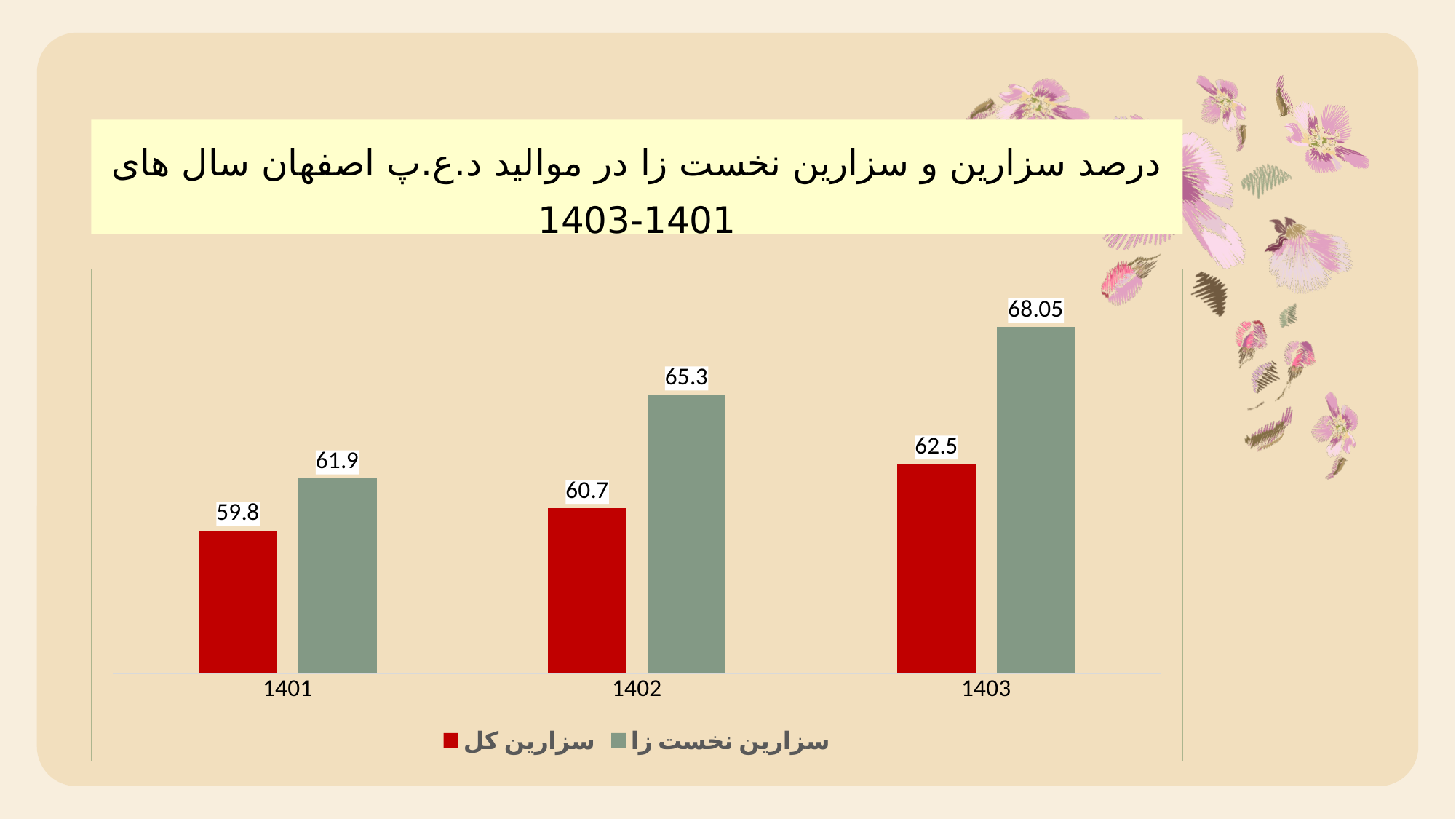
In which year is سزارین کل lowest? 1401 What is the value of سزارین کل for 1403? 62.5 Do the values of سزارین کل rise or fall from 1401 to 1403? Rise What is the difference between سزارین نخست زا and سزارین کل in 1402? 4.6 What is the value of سزارین نخست زا for 1402? 65.3 What is the value of سزارین نخست زا (grey-green bars) for 1403? 68.05 Which is larger in 1401: سزارین کل or سزارین نخست زا? سزارین نخست زا What type of chart is shown on the slide? Bar chart How many years (categories) are shown on the x axis? 3 How many series does the legend list? 2 What is the value of سزارین کل (red bars) for 1401? 59.8 In which year is سزارین نخست زا highest? 1403